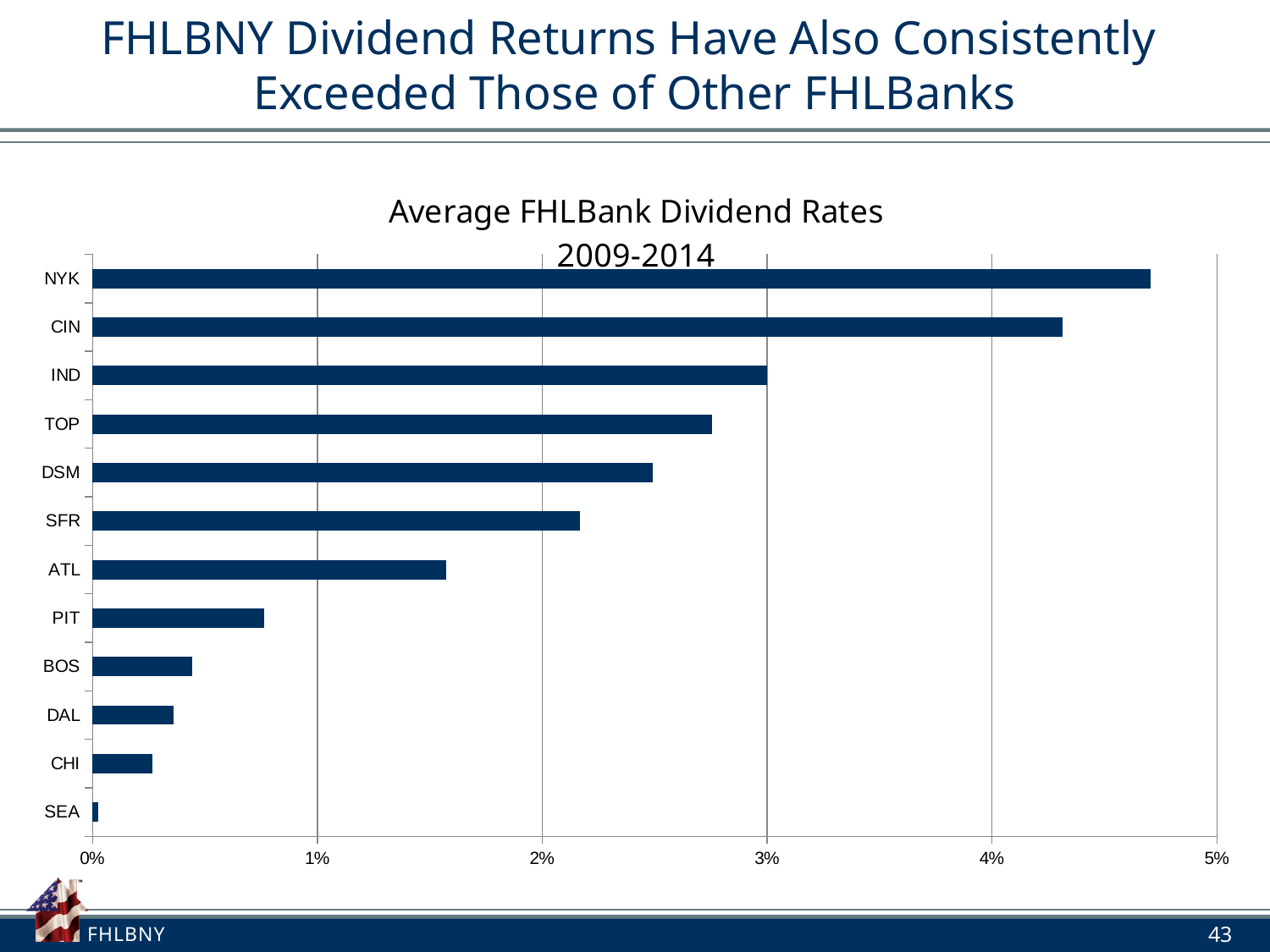
Is the value for PIT greater or less than 1%? less Is the value for TOP greater or less than 3%? less Do the bar values increase or decrease going from the top of the chart to the bottom? decrease What is the title of the chart? Average FHLBank Dividend Rates 2009-2014 Is the value for DSM greater or less than 2%? greater How many FHLBanks are shown in the chart? 12 Which FHLBank has the lowest average dividend rate? SEA What kind of chart is shown on the slide? bar chart Which FHLBank has the highest average dividend rate? NYK Which has a higher average dividend rate, NYK or CIN? NYK